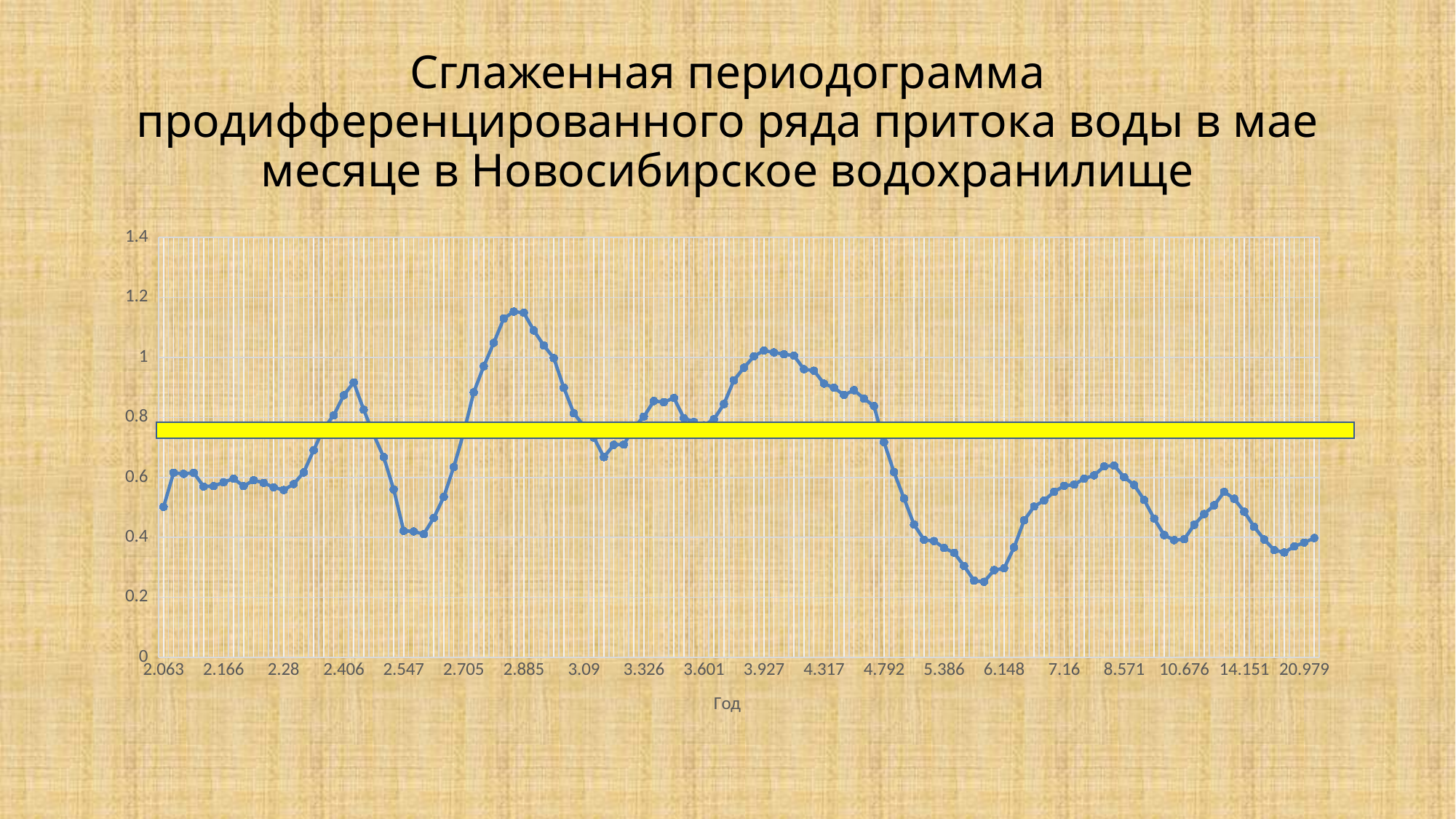
Around which x-axis label does the line reach its lowest value? 6.148 What colour is the horizontal band drawn across the chart? yellow Is the value at 2.063 greater or less than 0.6? less What is the title of the horizontal axis? Год Is the value at 3.927 greater or less than 0.8? greater How many labels are shown on the horizontal axis? 20 Is the value at 2.885 greater or less than 1? greater Around which x-axis label does the line reach its highest value? 2.885 Which is larger, the value at 2.885 or the value at 3.927? 2.885 What kind of chart is shown on the slide? line chart Does the line rise or fall between 4.792 and 6.148? fall